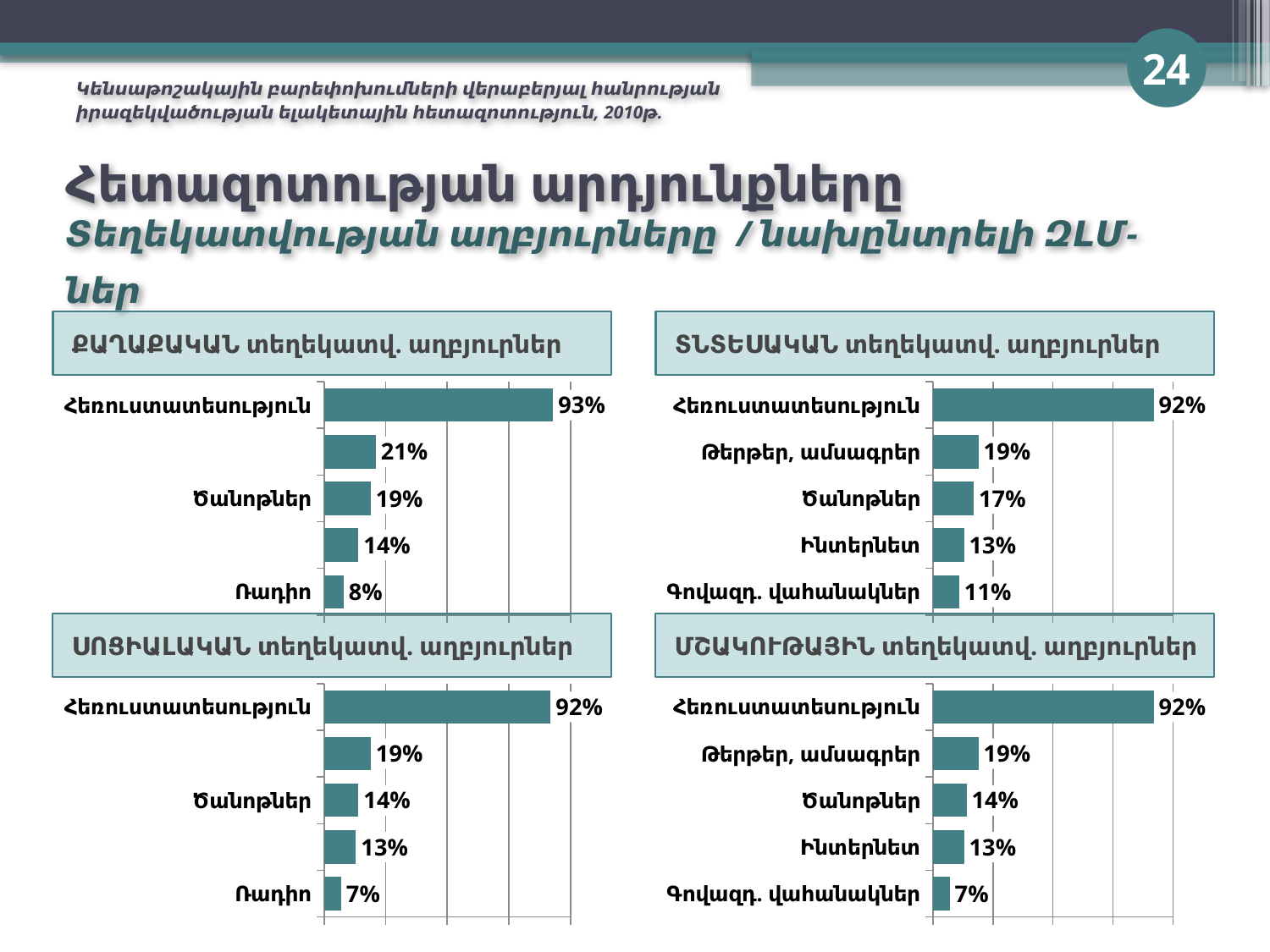
How many charts are shown on the slide? 4 In the top-right chart (ՏՆՏԵՍԱԿԱՆ տեղեկատվ. աղբյուրներ), which category has the highest value? Հեռուստատեսություն In the top-right chart (ՏՆՏԵՍԱԿԱՆ տեղեկատվ. աղբյուրներ), what is the value for Թերթեր, ամսագրեր? 19% In the bottom-left chart (ՍՈՑԻԱԼԱԿԱՆ տեղեկատվ. աղբյուրներ), which category has the lowest value? Ռադիո In the top-right chart (ՏՆՏԵՍԱԿԱՆ տեղեկատվ. աղբյուրներ), what is the value for Գովազդ. վահանակներ? 11% In the bottom-right chart (ՄՇԱԿՈՒԹԱՅԻՆ տեղեկատվ. աղբյուրներ), what is the difference between Հեռուստատեսություն and Գովազդ. վահանակներ? 85% In the top-right chart (ՏՆՏԵՍԱԿԱՆ տեղեկատվ. աղբյուրներ), which is larger: Ծանոթներ or Ինտերնետ? Ծանոթներ In the top-left chart (ՔԱՂԱՔԱԿԱՆ տեղեկատվ. աղբյուրներ), what is the value for Ռադիո? 8% What type of chart is the top-left chart (ՔԱՂԱՔԱԿԱՆ տեղեկատվ. աղբյուրներ)? Bar chart In the top-left chart (ՔԱՂԱՔԱԿԱՆ տեղեկատվ. աղբյուրներ), what is the value for Հեռուստատեսություն? 93% In the bottom-right chart (ՄՇԱԿՈՒԹԱՅԻՆ տեղեկատվ. աղբյուրներ), what is the value for Ինտերնետ? 13% How many bars does the bottom-left chart (ՍՈՑԻԱԼԱԿԱՆ տեղեկատվ. աղբյուրներ) have? 5